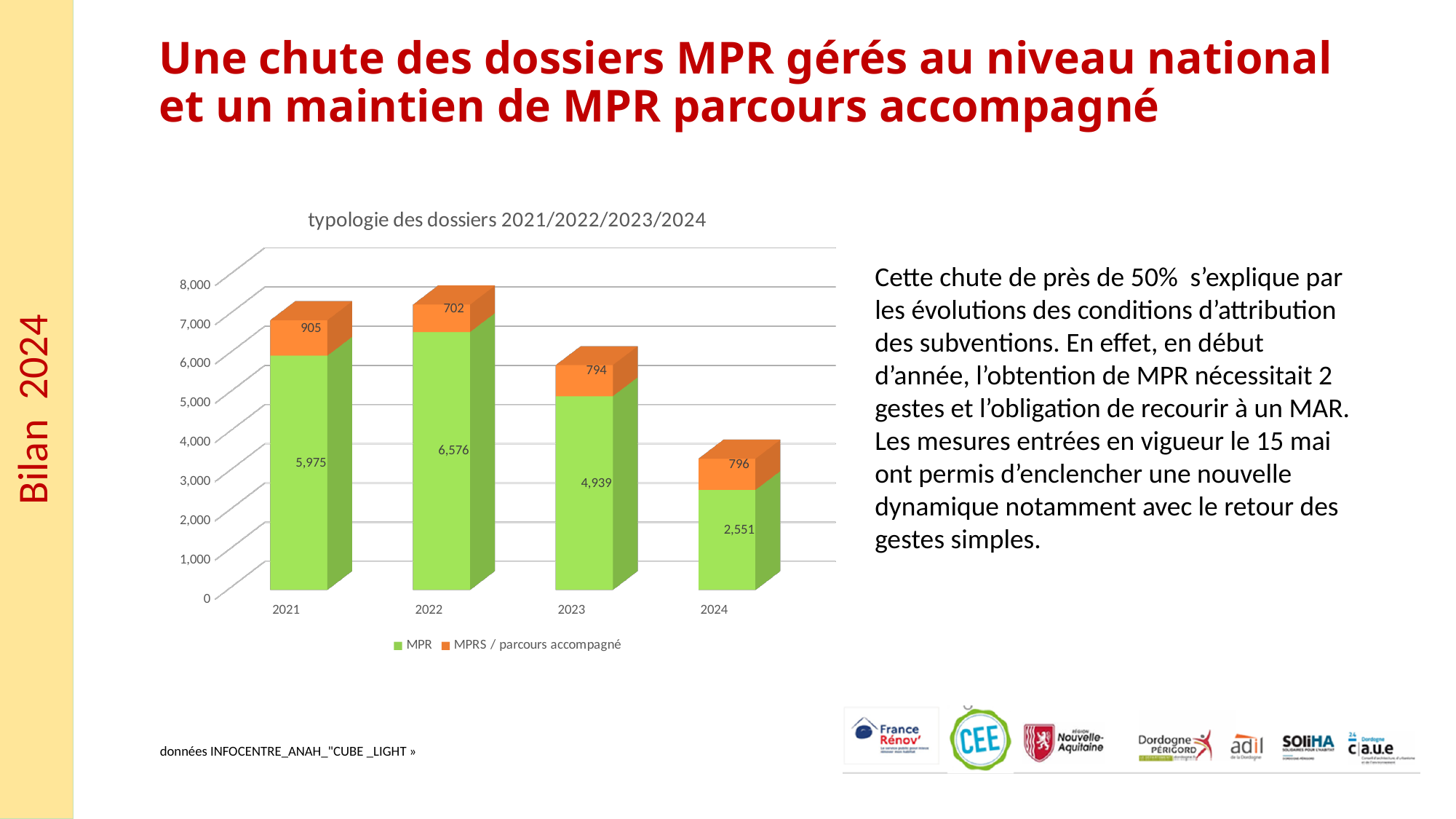
Which is larger, the MPRS / parcours accompagné value for 2021 or for 2022? 2021 What is the MPR value for 2021? 5,975 How many years are shown on the x axis? 4 What kind of chart is shown? Stacked bar chart Which year has the highest MPR value? 2022 What is the total of the stacked bar for 2022? 7,278 Which year has the lowest MPRS / parcours accompagné value? 2022 What is the total of the stacked bar for 2024? 3,347 How many series does the legend list? 2 What is the difference between the MPR values for 2021 and 2024? 3,424 What is the MPRS / parcours accompagné value for 2023? 794 What is the MPR value for 2024? 2,551